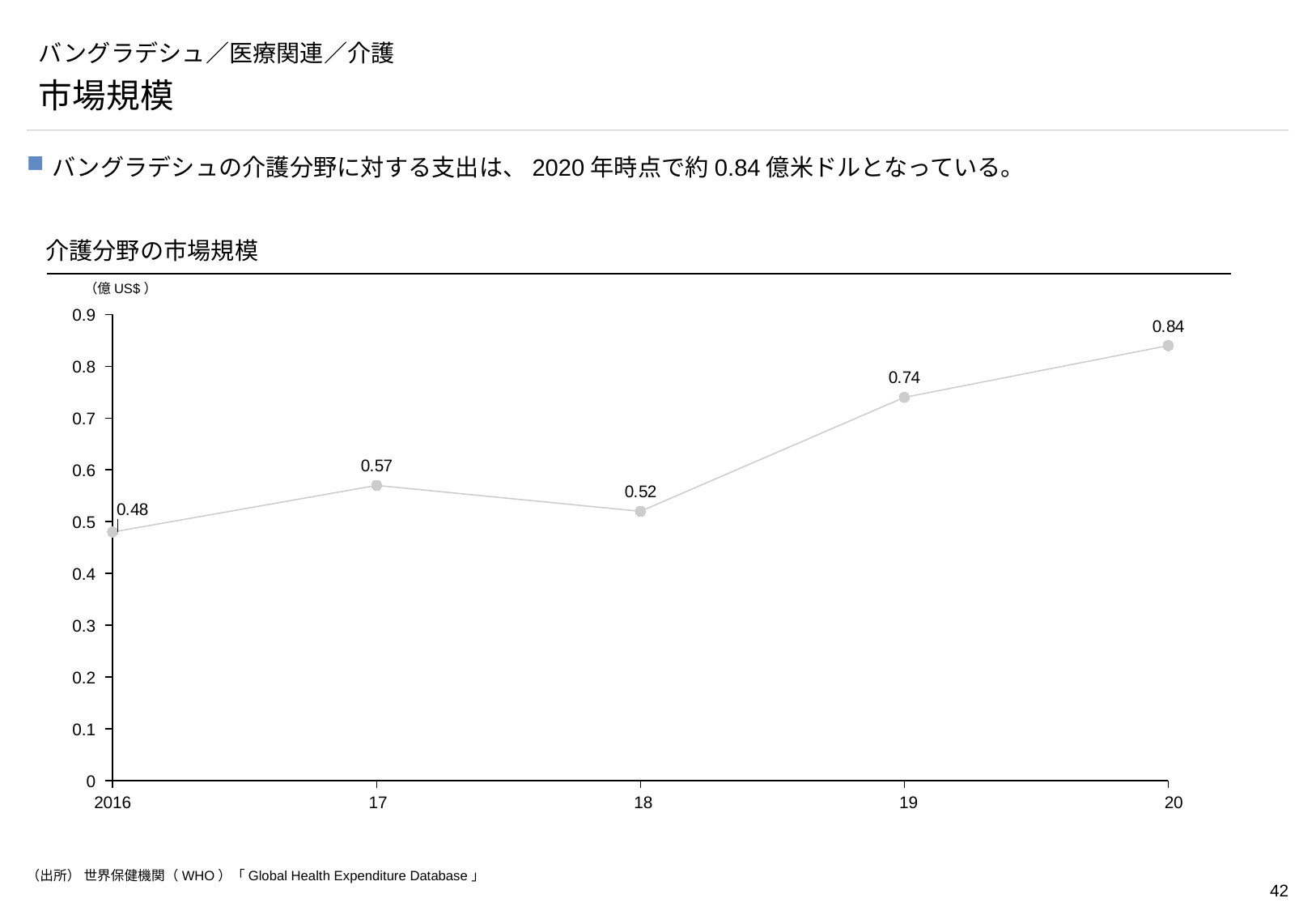
What is the difference between the 2020 and 2016 values in the 介護分野の市場規模 chart? 0.36 What unit is shown on the y axis of the 介護分野の市場規模 chart? 億 US$ What is the difference between the 2019 and 2018 values in the 介護分野の市場規模 chart? 0.22 What is the value for 2018 in the 介護分野の市場規模 chart? 0.52 Which year has the lowest value in the 介護分野の市場規模 chart? 2016 Which is larger in the 介護分野の市場規模 chart, the value for 2017 or the value for 2018? 2017 What is the value for 2020 in the 介護分野の市場規模 chart? 0.84 Which year has the highest value in the 介護分野の市場規模 chart? 2020 What is the value for 2016 in the 介護分野の市場規模 chart? 0.48 Does the value in the 介護分野の市場規模 chart rise or fall from 2018 to 2020? Rise What kind of chart is the 介護分野の市場規模 chart? Line chart How many data points are plotted in the 介護分野の市場規模 chart? 5